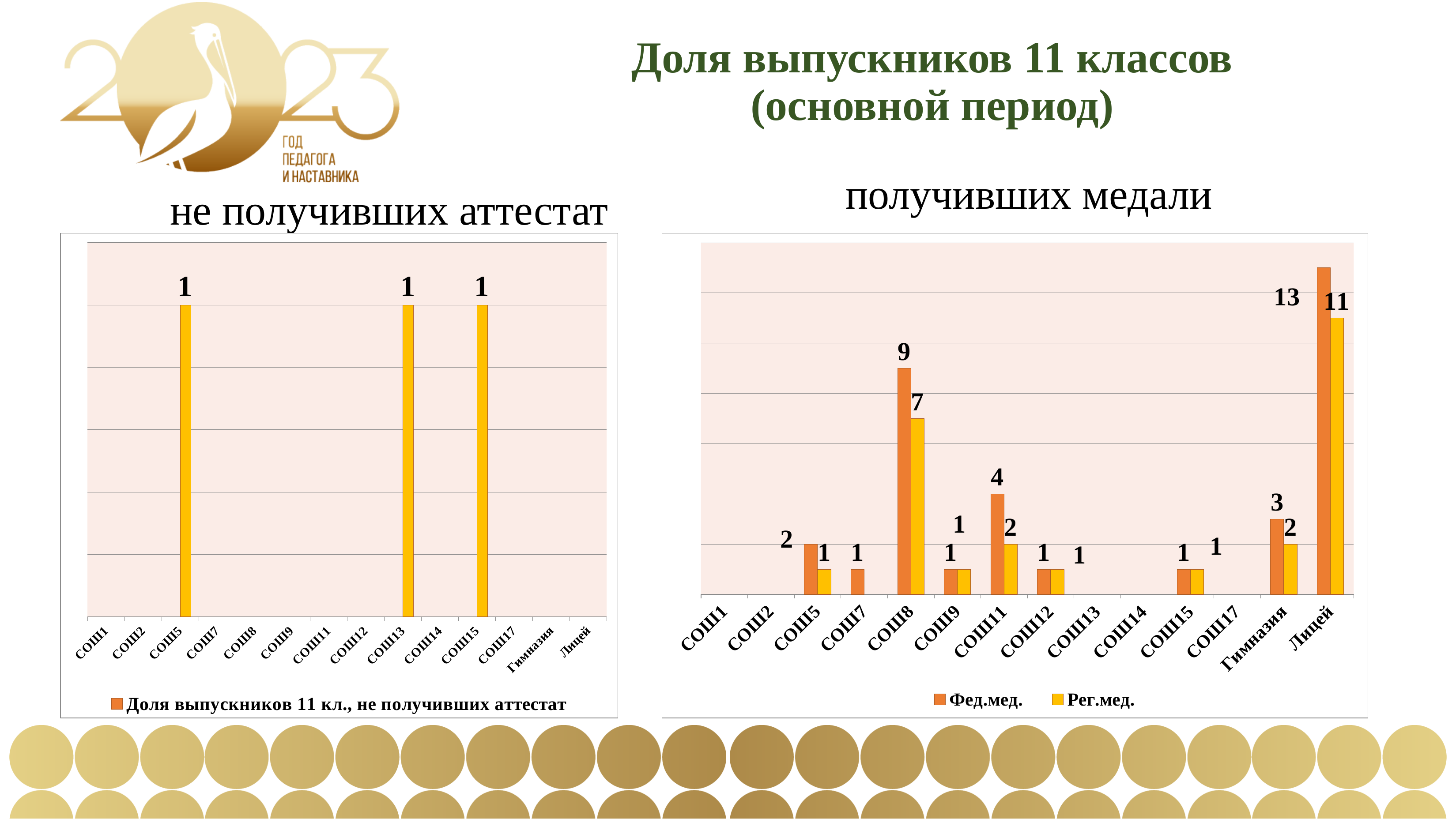
In the chart titled "получивших медали", how many series does the legend list? 2 In the chart titled "не получивших аттестат", what is the value for СОШ5? 1 In the chart titled "не получивших аттестат", what kind of chart is it? bar chart In the chart titled "получивших медали", what is the difference between the Фед.мед. values for СОШ8 and СОШ11? 5 In the chart titled "не получивших аттестат", how many categories are shown on the x axis? 14 In the chart titled "получивших медали", which is larger for СОШ11: Фед.мед. or Рег.мед.? Фед.мед. In the chart titled "получивших медали", which category has the highest Фед.мед. value? Лицей In the chart titled "получивших медали", what is the Рег.мед. value for СОШ8? 7 In the chart titled "не получивших аттестат", what is the legend entry? Доля выпускников 11 кл., не получивших аттестат In the chart titled "получивших медали", what is the Фед.мед. value for Лицей? 13 In the chart titled "получивших медали", what is the Фед.мед. value for Гимназия? 3 In the chart titled "получивших медали", what is the difference between the Фед.мед. and Рег.мед. values for Лицей? 2